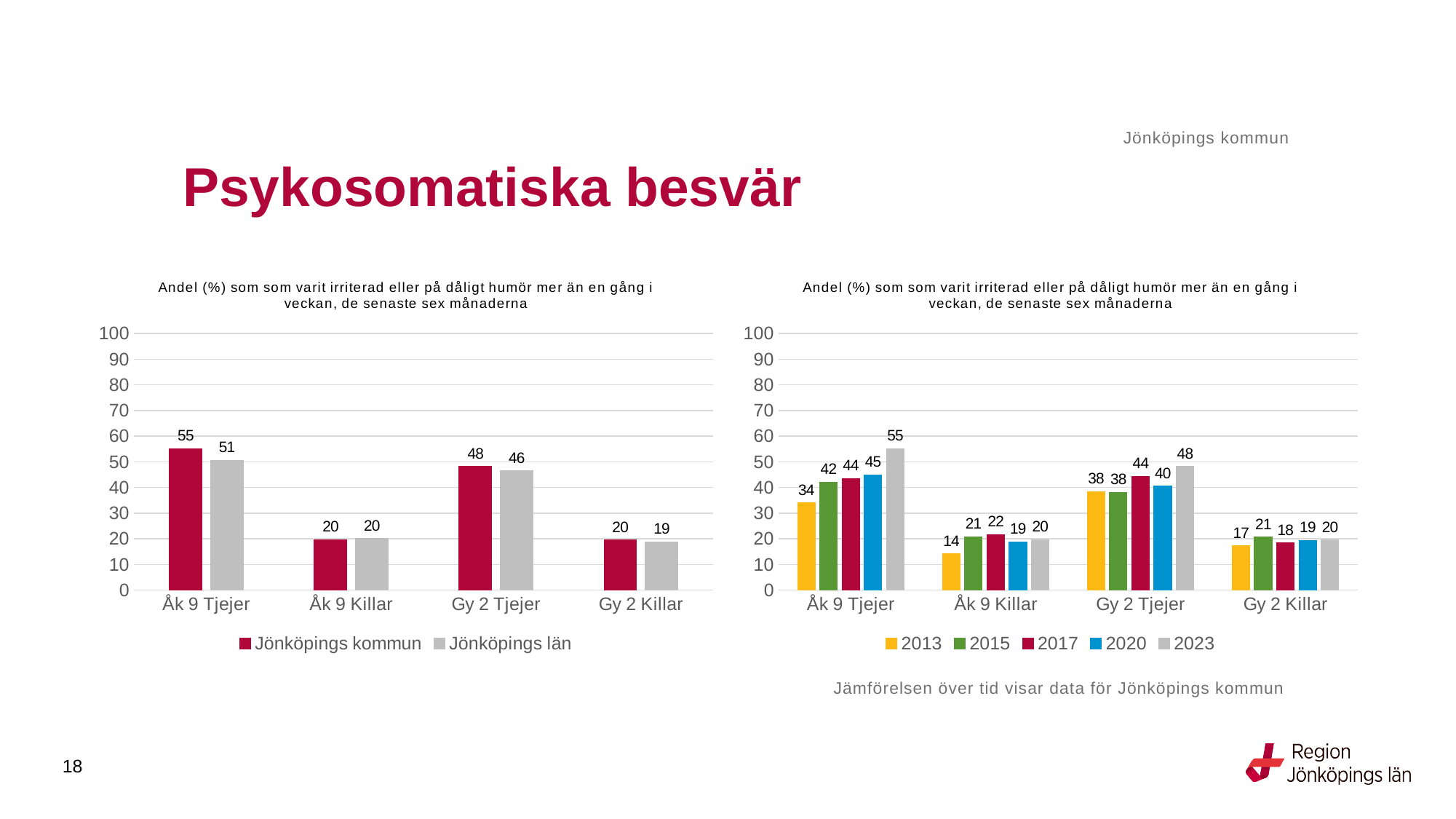
In the left chart, how many series does the legend list? 2 In the left chart, which category has the highest value for Jönköpings kommun? Åk 9 Tjejer In the left chart, what is the value for Jönköpings kommun for Åk 9 Tjejer? 55 In the left chart, what is the value for Jönköpings län for Gy 2 Tjejer? 46 In the right chart, how many series does the legend list? 5 In the right chart, what is the value for 2013 for Åk 9 Killar? 14 In the right chart, what is the difference between the 2023 and 2013 values for Åk 9 Tjejer? 21 In the right chart, is the 2017 value for Gy 2 Tjejer larger or smaller than the 2020 value? larger What kind of chart is the right chart? bar chart In the right chart, which year has the lowest value for Åk 9 Tjejer? 2013 In the right chart, what is the value for 2023 for Gy 2 Tjejer? 48 In the left chart, what is the difference between Jönköpings kommun and Jönköpings län for Åk 9 Tjejer? 4